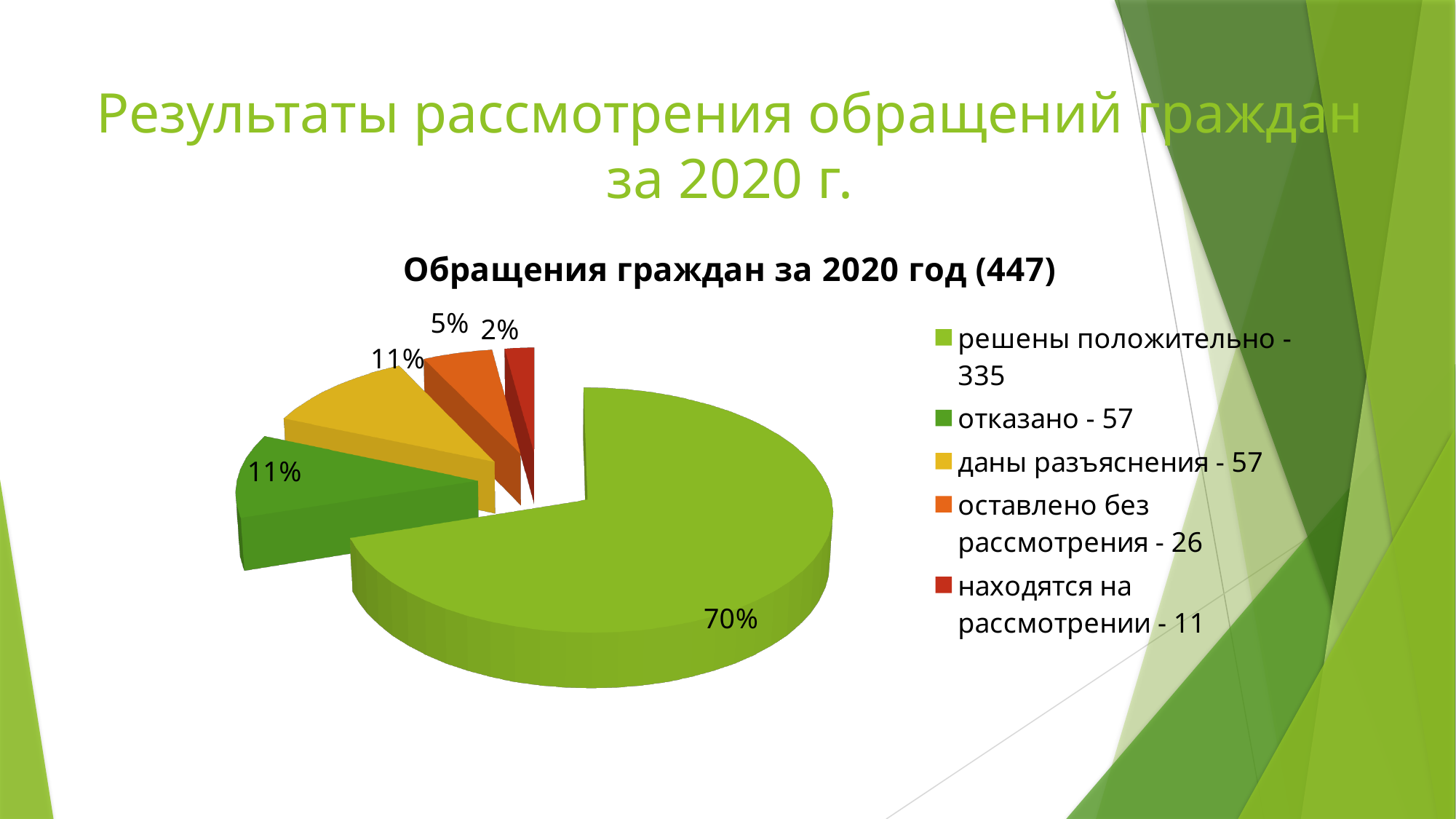
What is the title of the chart? Обращения граждан за 2020 год (447) Which category has the smallest slice of the pie? находятся на рассмотрении What share of the pie is labelled for "решены положительно"? 70% What kind of chart is shown on the slide? pie chart Which category has the largest slice of the pie? решены положительно How many slices does the pie chart have? 5 According to the legend, how many appeals were "решены положительно"? 335 What is the difference between the number of appeals "решены положительно" (335) and "отказано" (57)? 278 According to the legend, how many appeals were "отказано"? 57 Which is larger: the slice for "оставлено без рассмотрения" or the slice for "находятся на рассмотрении"? оставлено без рассмотрения What share of the pie is labelled for "находятся на рассмотрении"? 2% What share of the pie is labelled for "оставлено без рассмотрения"? 5%